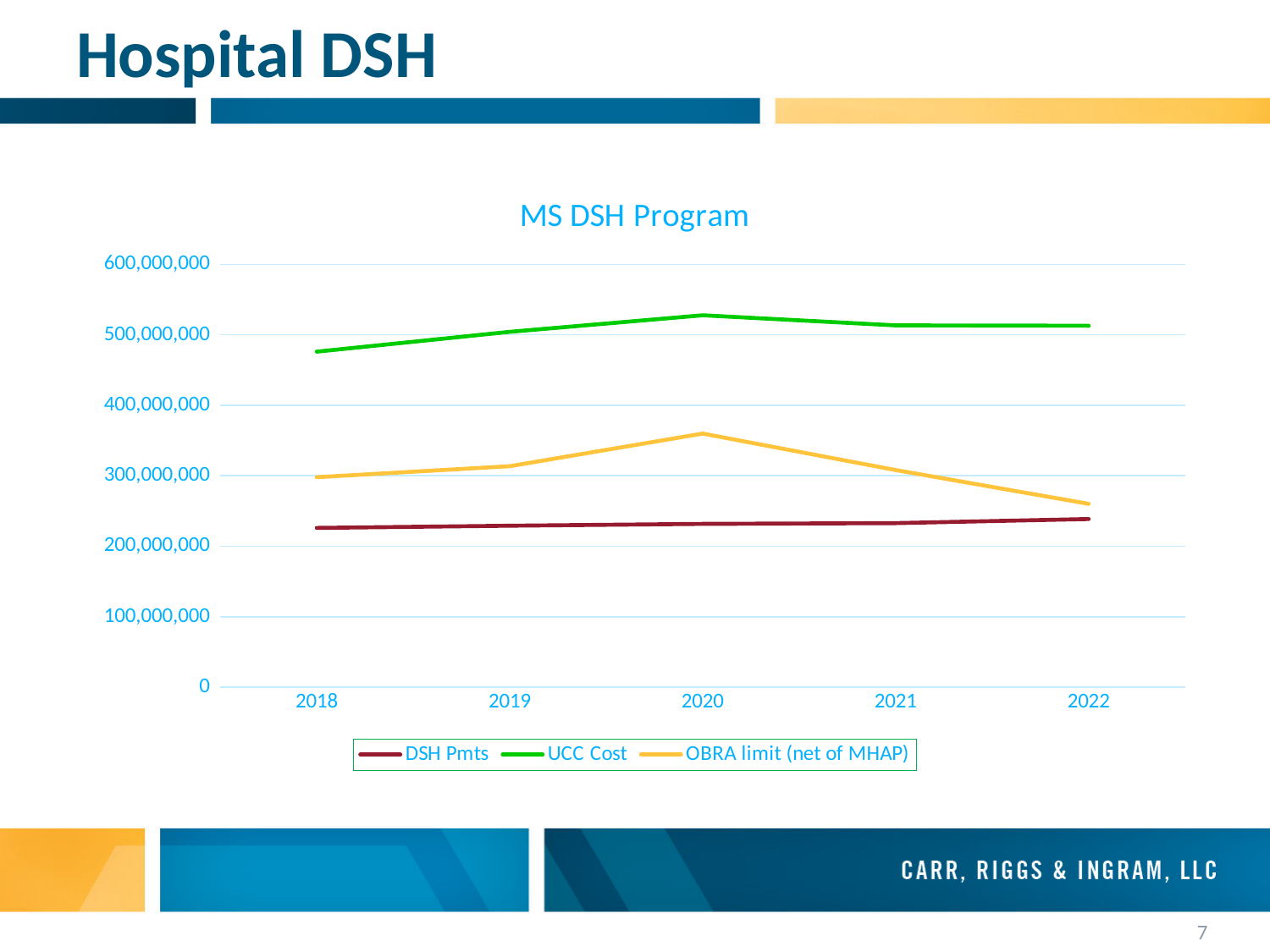
Is the DSH Pmts value for 2018 greater or less than 200,000,000? greater Does the DSH Pmts line generally rise or fall from 2018 to 2022? rise What kind of chart is shown on the slide? Line chart Is the OBRA limit (net of MHAP) value for 2022 greater or less than 300,000,000? less In which year is the UCC Cost line at its highest? 2020 In which year is the OBRA limit (net of MHAP) line at its lowest? 2022 In 2022, which series has the larger value: UCC Cost or OBRA limit (net of MHAP)? UCC Cost What is the title of the chart on the slide? MS DSH Program How many series does the legend of the MS DSH Program chart list? 3 Is the UCC Cost value for 2018 greater or less than 500,000,000? less In which year is the OBRA limit (net of MHAP) line at its highest? 2020 How many years are plotted along the x axis of the MS DSH Program chart? 5